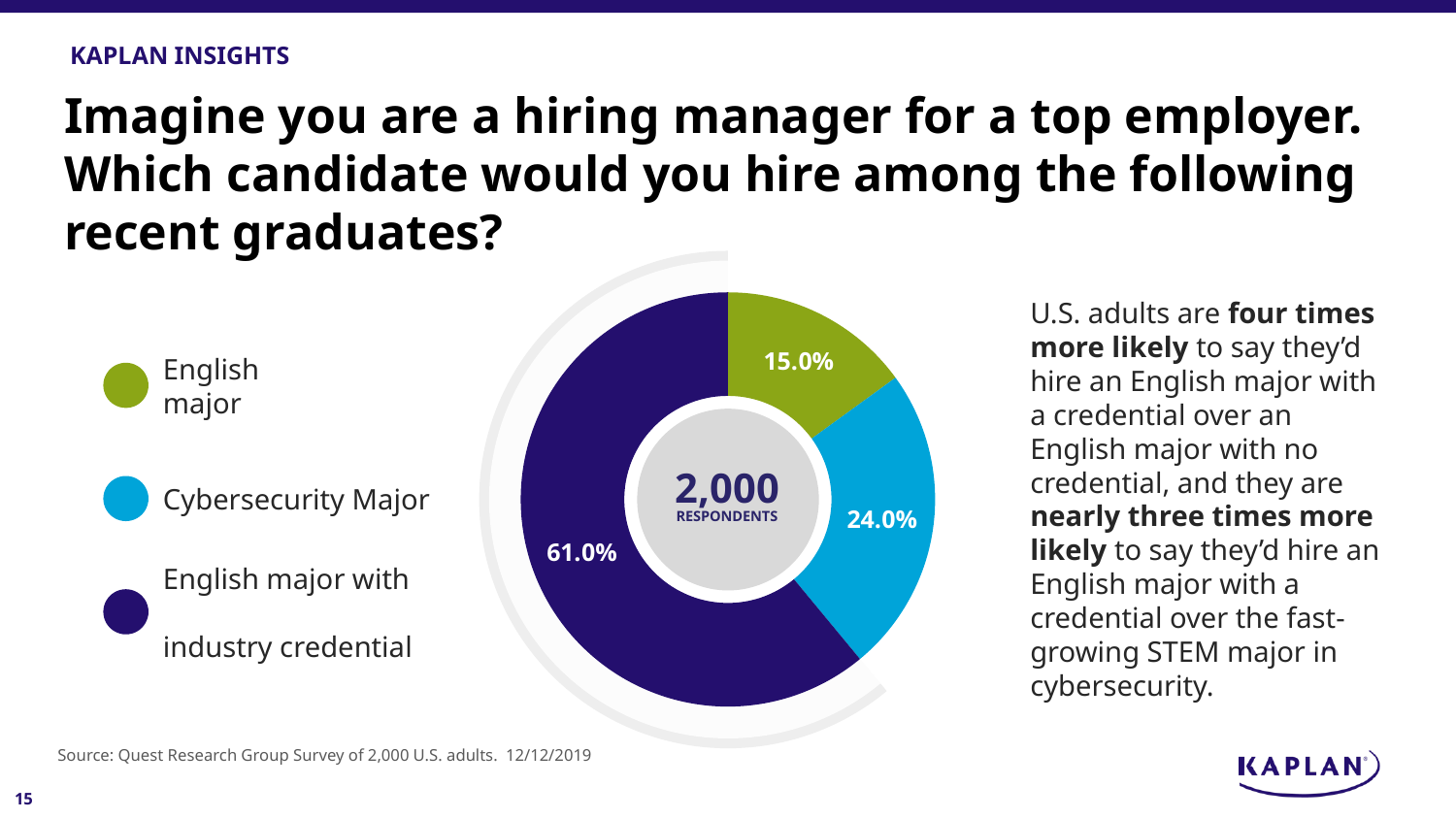
What kind of chart is shown on the slide? Pie chart (donut) What is the difference in percentage points between the Cybersecurity Major and the English major? 9.0 How many candidate categories are shown in the chart? 3 What is the difference in percentage points between the English major with industry credential and the Cybersecurity Major? 37.0 What percentage of respondents would hire the English major? 15.0% Which received a larger share: the Cybersecurity Major or the English major? Cybersecurity Major What colour represents the Cybersecurity Major in the chart? Light blue Which candidate received the smallest share of responses? English major How many respondents does the centre of the chart report? 2,000 What percentage of respondents would hire the Cybersecurity Major? 24.0% Which candidate received the largest share of responses? English major with industry credential What percentage of respondents would hire the English major with industry credential? 61.0%